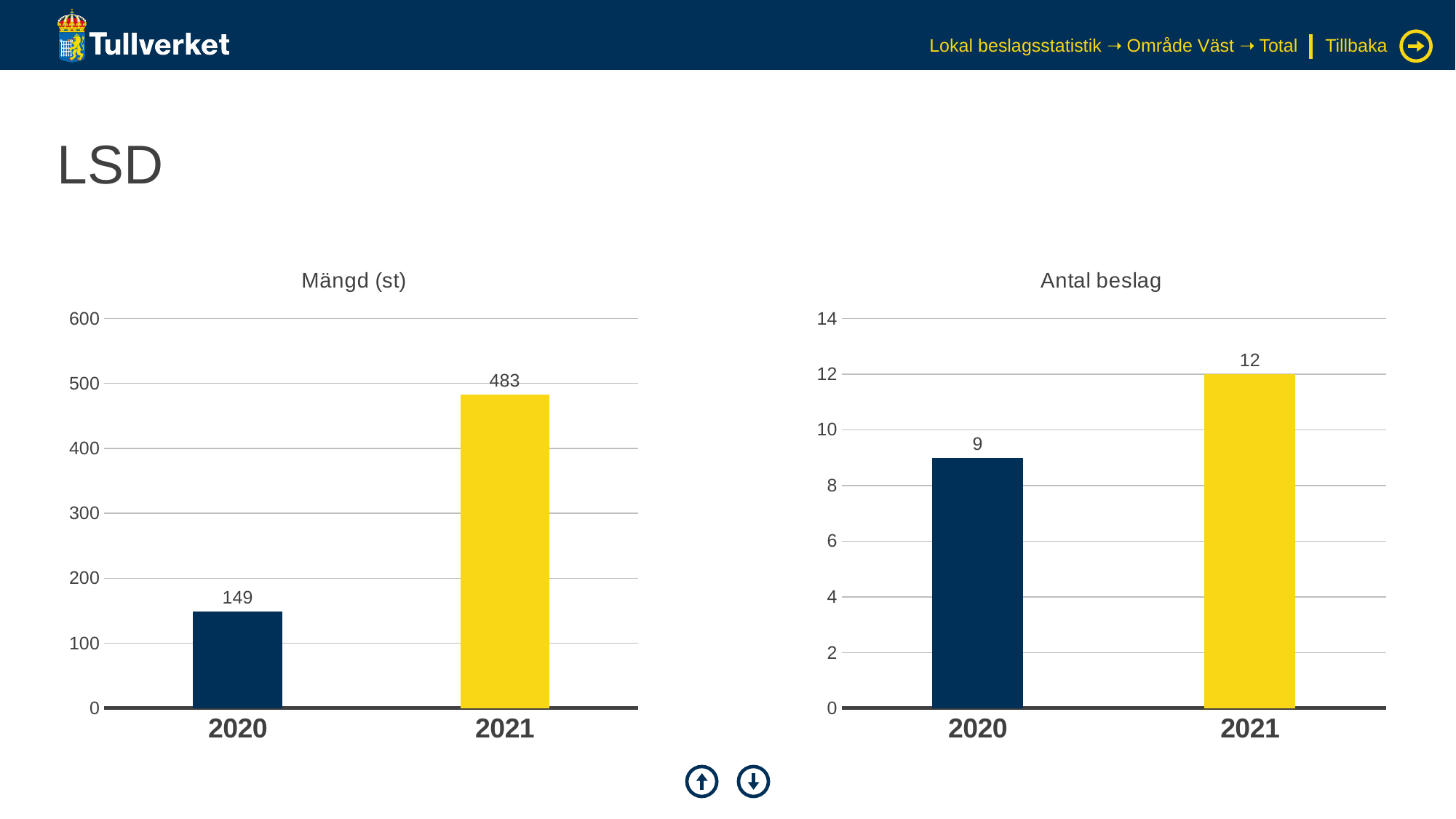
In the 'Mängd (st)' chart, what is the value for 2021? 483 In the 'Mängd (st)' chart, what is the difference between the 2021 and 2020 values? 334 In the 'Antal beslag' chart, which year has the lowest value? 2020 In the 'Mängd (st)' chart, how many years are shown on the x axis? 2 What kind of chart is the 'Antal beslag' chart? bar chart In the 'Mängd (st)' chart, do the values rise or fall from 2020 to 2021? rise In the 'Antal beslag' chart, what is the value for 2021? 12 In the 'Antal beslag' chart, is the value for 2020 larger or smaller than the value for 2021? smaller In the 'Antal beslag' chart, what is the difference between the 2021 and 2020 values? 3 In the 'Mängd (st)' chart, what is the value for 2020? 149 In the 'Antal beslag' chart, what is the value for 2020? 9 In the 'Mängd (st)' chart, which year has the highest value? 2021